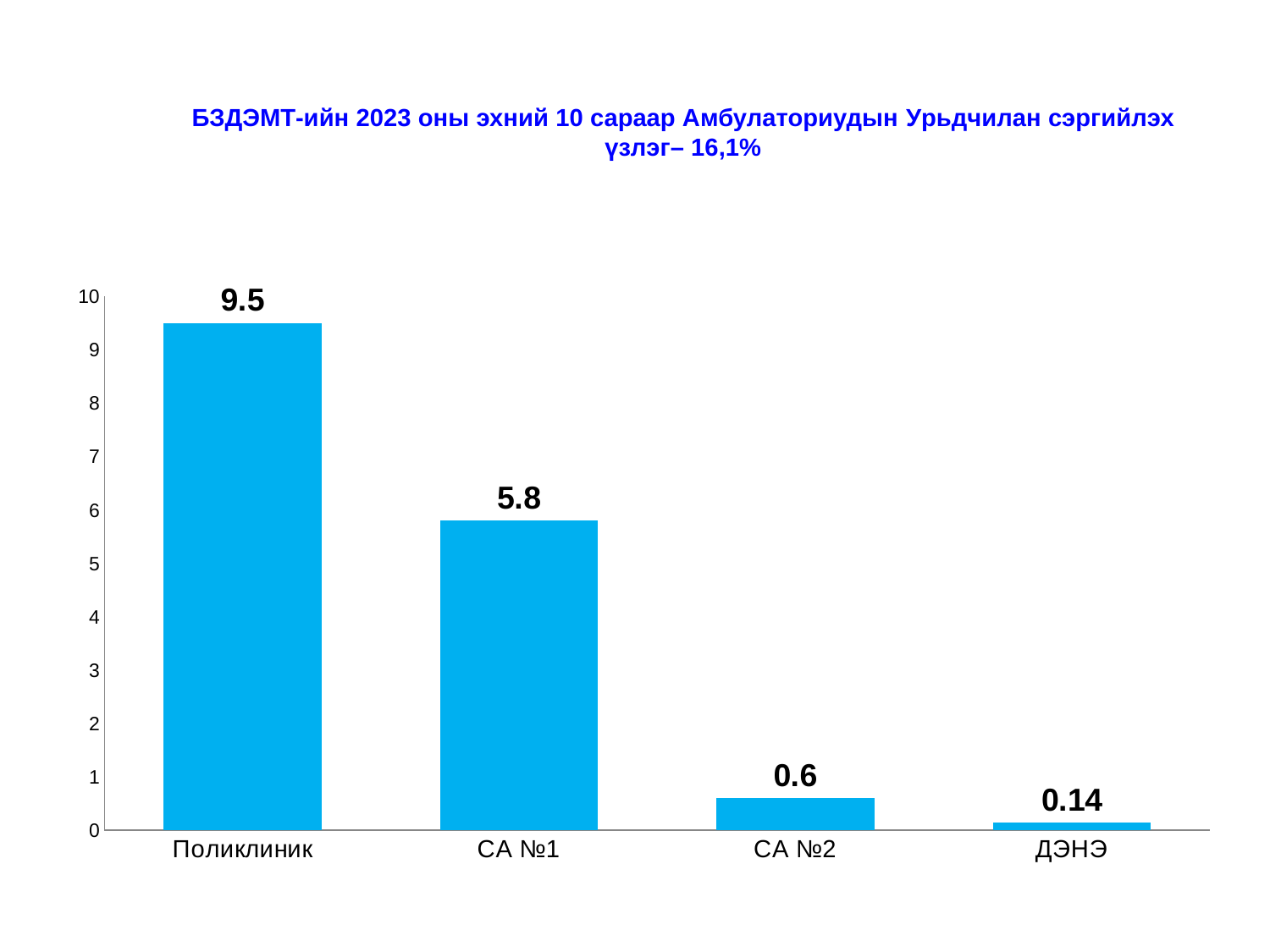
Which category has the lowest value? ДЭНЭ What kind of chart is shown on the slide? bar chart How many categories are shown on the x axis? 4 What is the value for Поликлиник? 9.5 What is the difference between the values for Поликлиник and СА №1? 3.7 What is the value for СА №2? 0.6 What is the value for ДЭНЭ? 0.14 Do the values rise or fall from left to right along the x axis? fall Which is larger, the value for СА №1 or the value for СА №2? СА №1 What is the value for СА №1? 5.8 Is the value for СА №1 greater or less than 5? greater Which category has the highest value? Поликлиник